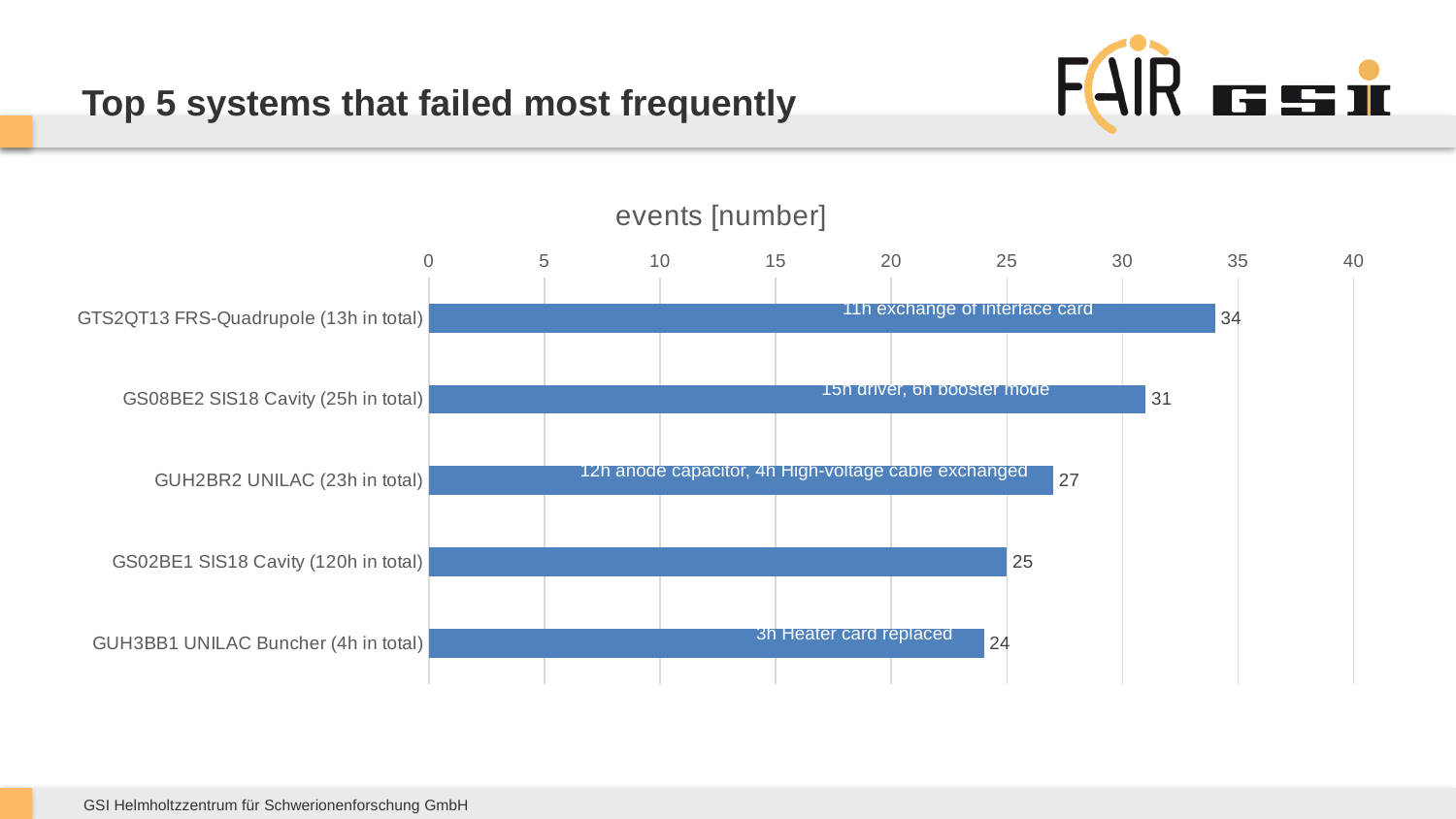
What is the difference in events between GTS2QT13 FRS-Quadrupole and GUH3BB1 UNILAC Buncher? 10 Which system has the highest number of events? GTS2QT13 FRS-Quadrupole (13h in total) What is the title of the chart? events [number] How many events are shown for GTS2QT13 FRS-Quadrupole (13h in total)? 34 Which has more events, GS02BE1 SIS18 Cavity (120h in total) or GUH2BR2 UNILAC (23h in total)? GUH2BR2 UNILAC (23h in total) What is the value for GUH2BR2 UNILAC (23h in total)? 27 What is the value for GUH3BB1 UNILAC Buncher (4h in total)? 24 How many systems are shown in the chart? 5 What is the value for GS08BE2 SIS18 Cavity (25h in total)? 31 Is the value for GS08BE2 SIS18 Cavity (25h in total) greater or less than 30? greater What kind of chart is shown on the slide? bar chart Which system has the lowest number of events? GUH3BB1 UNILAC Buncher (4h in total)